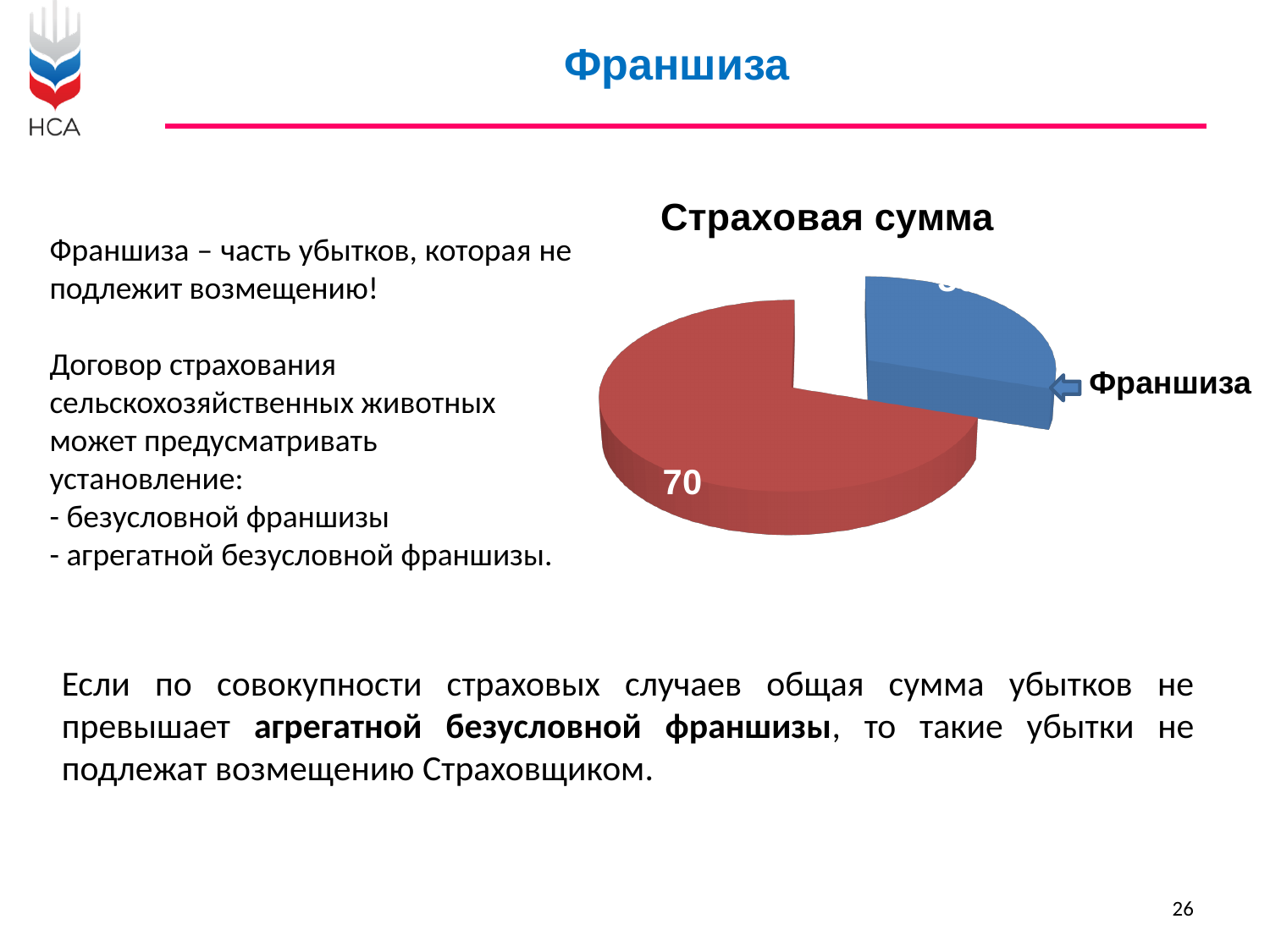
Is the slice marked Франшиза larger or smaller than the red slice? smaller How many slices does the pie chart have? 2 What colour is the slice marked Франшиза? blue What is the title of the chart? Страховая сумма Which slice of the pie chart is the largest, the red slice or the slice marked Франшиза? the red slice What value is printed on the red slice of the pie chart? 70 What kind of chart is shown on the slide? pie chart Which slice of the pie chart is the smallest? the slice marked Франшиза